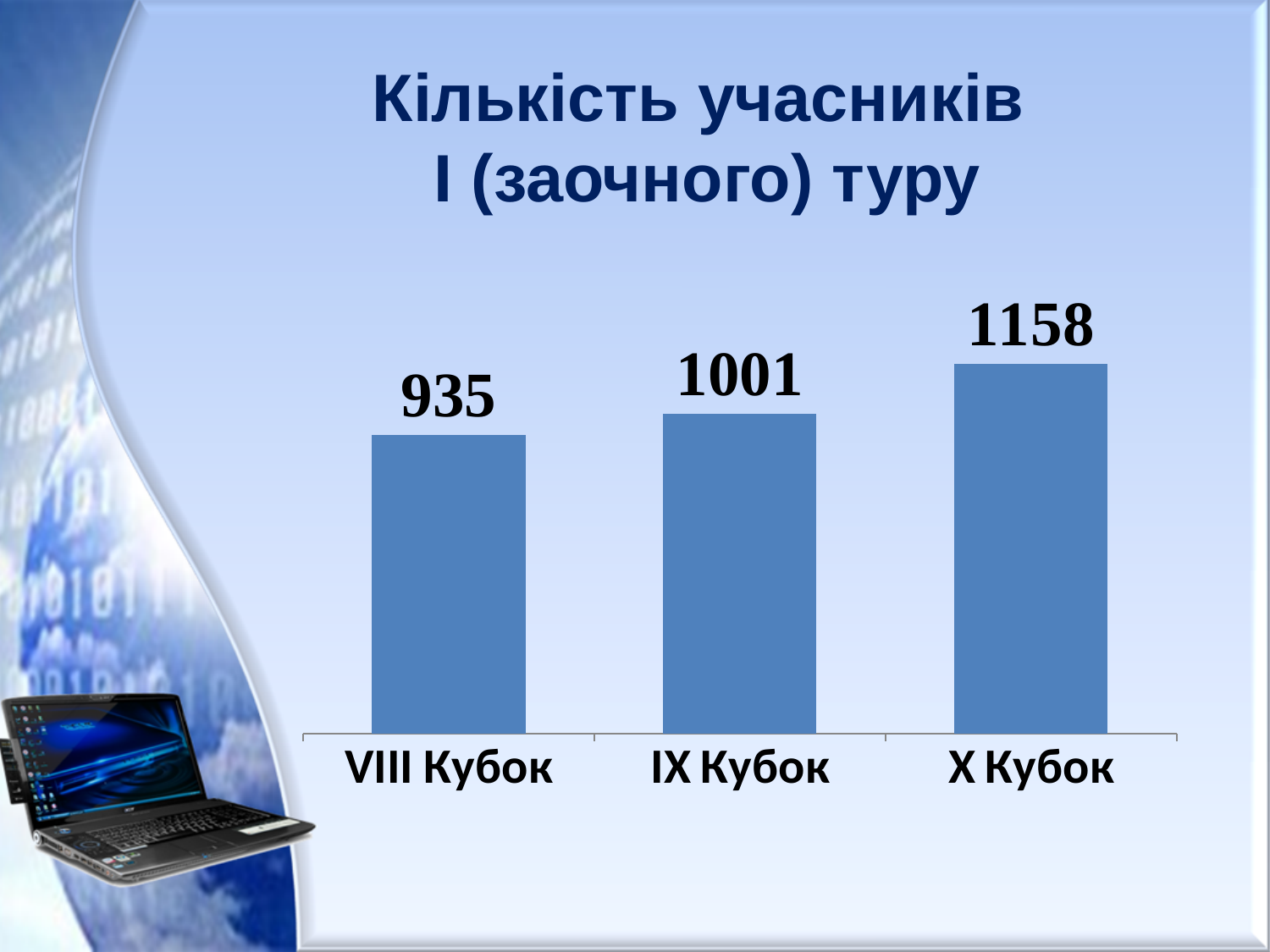
What is the difference between the values for X Кубок and IX Кубок? 157 What is the value for IX Кубок? 1001 What is the value for VIII Кубок? 935 How many categories are shown in the chart? 3 Which category has the lowest value? VIII Кубок Do the values rise or fall from VIII Кубок to X Кубок? rise What is the difference between the values for X Кубок and VIII Кубок? 223 What kind of chart is shown on the slide? bar chart What is the difference between the values for IX Кубок and VIII Кубок? 66 What is the value for X Кубок? 1158 Which category has the highest value? X Кубок Which is larger, the value for IX Кубок or the value for X Кубок? X Кубок